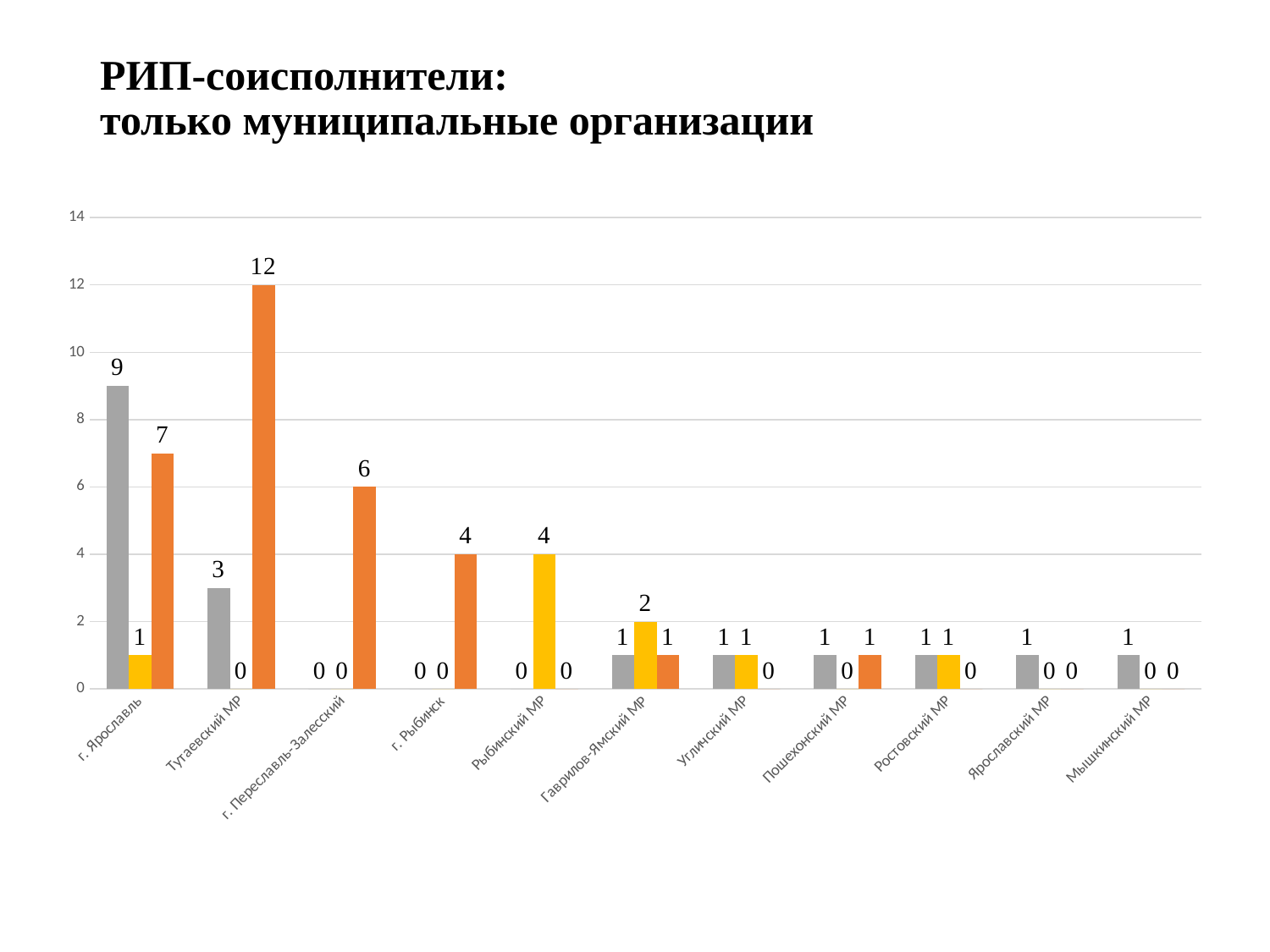
What is the difference between the grey bar and the orange bar for г. Ярославль? 2 What is the value of the yellow bar for Гаврилов-Ямский МР? 2 What is the title of the slide? РИП-соисполнители: только муниципальные организации Is the orange bar for Тутаевский МР greater or less than 10? greater How many categories are shown on the x axis? 11 What is the value of the orange bar for Тутаевский МР? 12 Which is larger: the orange bar for г. Рыбинск or the orange bar for г. Переславль-Залесский? г. Переславль-Залесский What type of chart is shown on the slide? bar chart Which category has the tallest bar on the chart? Тутаевский МР What is the value of the grey bar for г. Ярославль? 9 What is the value of the orange bar for г. Переславль-Залесский? 6 What is the value of the yellow bar for Рыбинский МР? 4